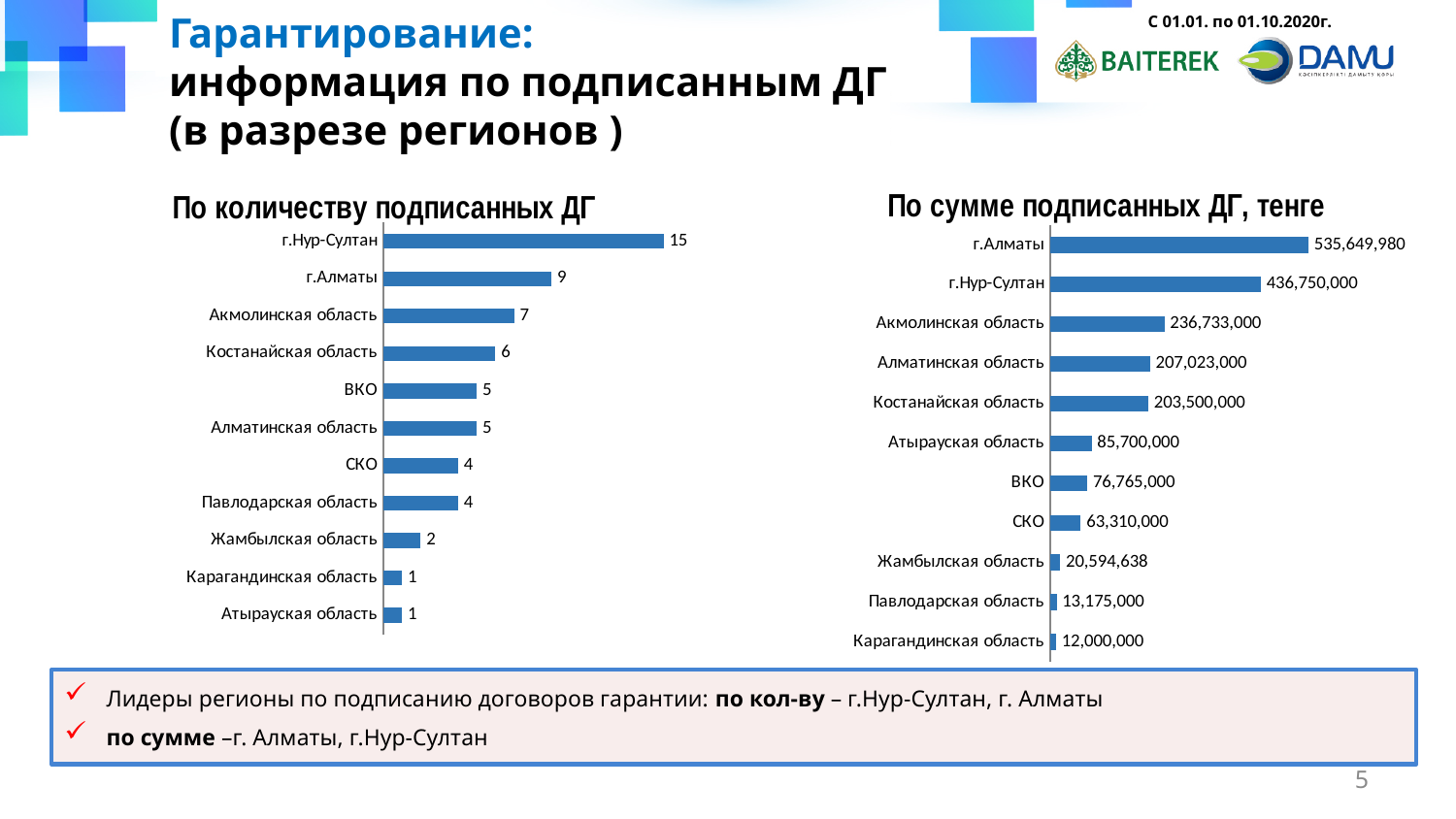
In the chart 'По количеству подписанных ДГ', what is the difference between г.Нур-Султан and г.Алматы? 6 In the chart 'По сумме подписанных ДГ, тенге', what is the difference between г.Нур-Султан and Акмолинская область? 200,017,000 In the chart 'По количеству подписанных ДГ', how many regions are shown? 11 In the chart 'По сумме подписанных ДГ, тенге', what is the value for Атырауская область? 85,700,000 What type of chart is 'По сумме подписанных ДГ, тенге'? Bar chart In the chart 'По сумме подписанных ДГ, тенге', what is the value for г.Алматы? 535,649,980 In the chart 'По количеству подписанных ДГ', which region has the highest value? г.Нур-Султан In the chart 'По количеству подписанных ДГ', what is the value for г.Нур-Султан? 15 What is the title of the chart on the left side of the slide? По количеству подписанных ДГ In the chart 'По количеству подписанных ДГ', what is the value for Костанайская область? 6 In the chart 'По сумме подписанных ДГ, тенге', which region has the lowest value? Карагандинская область In the chart 'По сумме подписанных ДГ, тенге', which is larger: Акмолинская область or Алматинская область? Акмолинская область